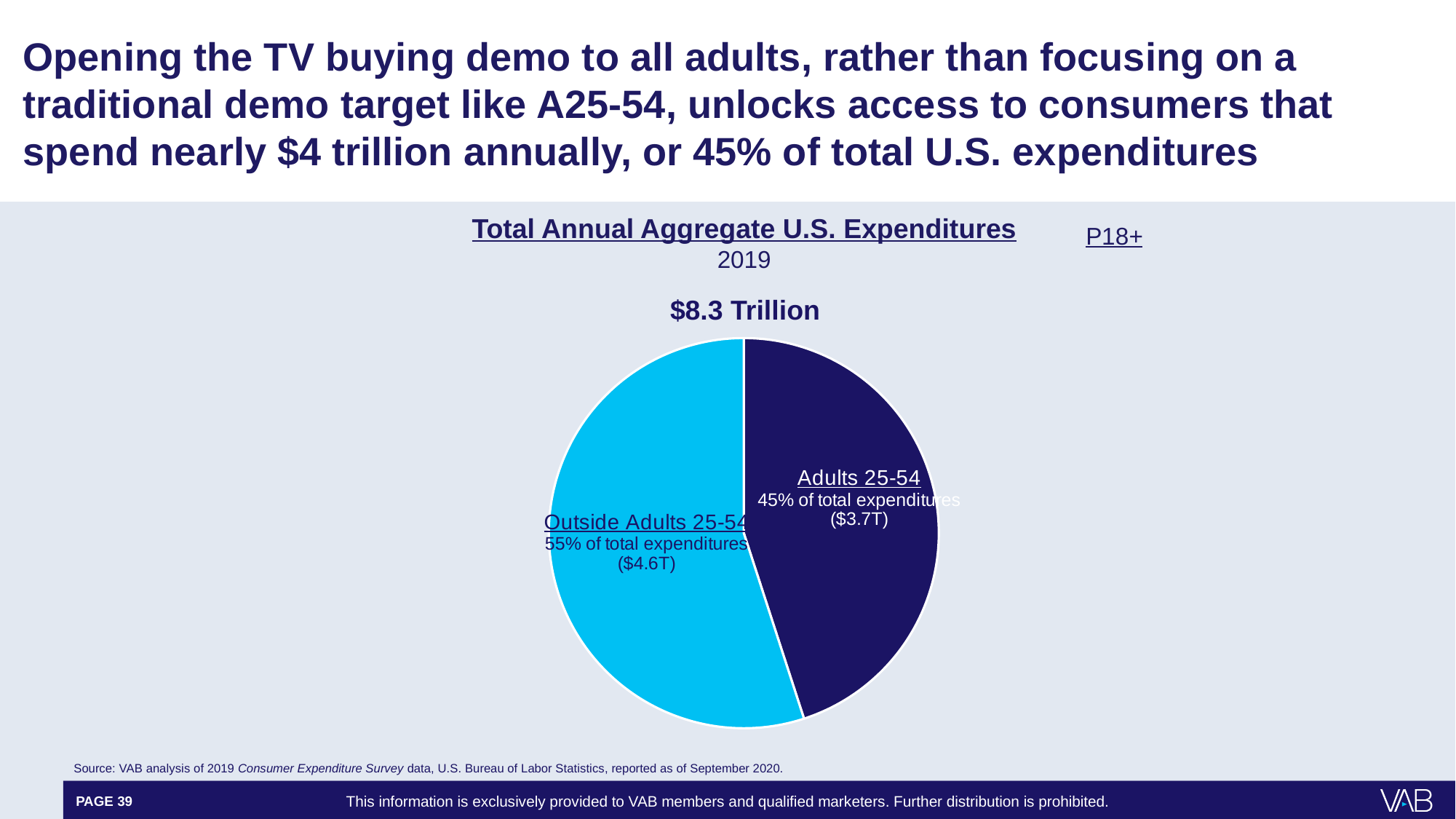
What share of total expenditures does the Adults 25-54 slice represent? 45% Which slice of the pie is the smallest? Adults 25-54 Which slice of the pie is the largest? Outside Adults 25-54 What dollar value is shown for the Adults 25-54 slice? $3.7T What kind of chart is shown on the slide? pie chart How many slices does the pie chart have? 2 What total value is shown above the pie chart? $8.3 Trillion What share of total expenditures does the Outside Adults 25-54 slice represent? 55% What is the title of the chart? Total Annual Aggregate U.S. Expenditures What is the difference in percentage points between the Outside Adults 25-54 share and the Adults 25-54 share? 10 percentage points Which is larger, the Adults 25-54 slice or the Outside Adults 25-54 slice? Outside Adults 25-54 What dollar value is shown for the Outside Adults 25-54 slice? $4.6T